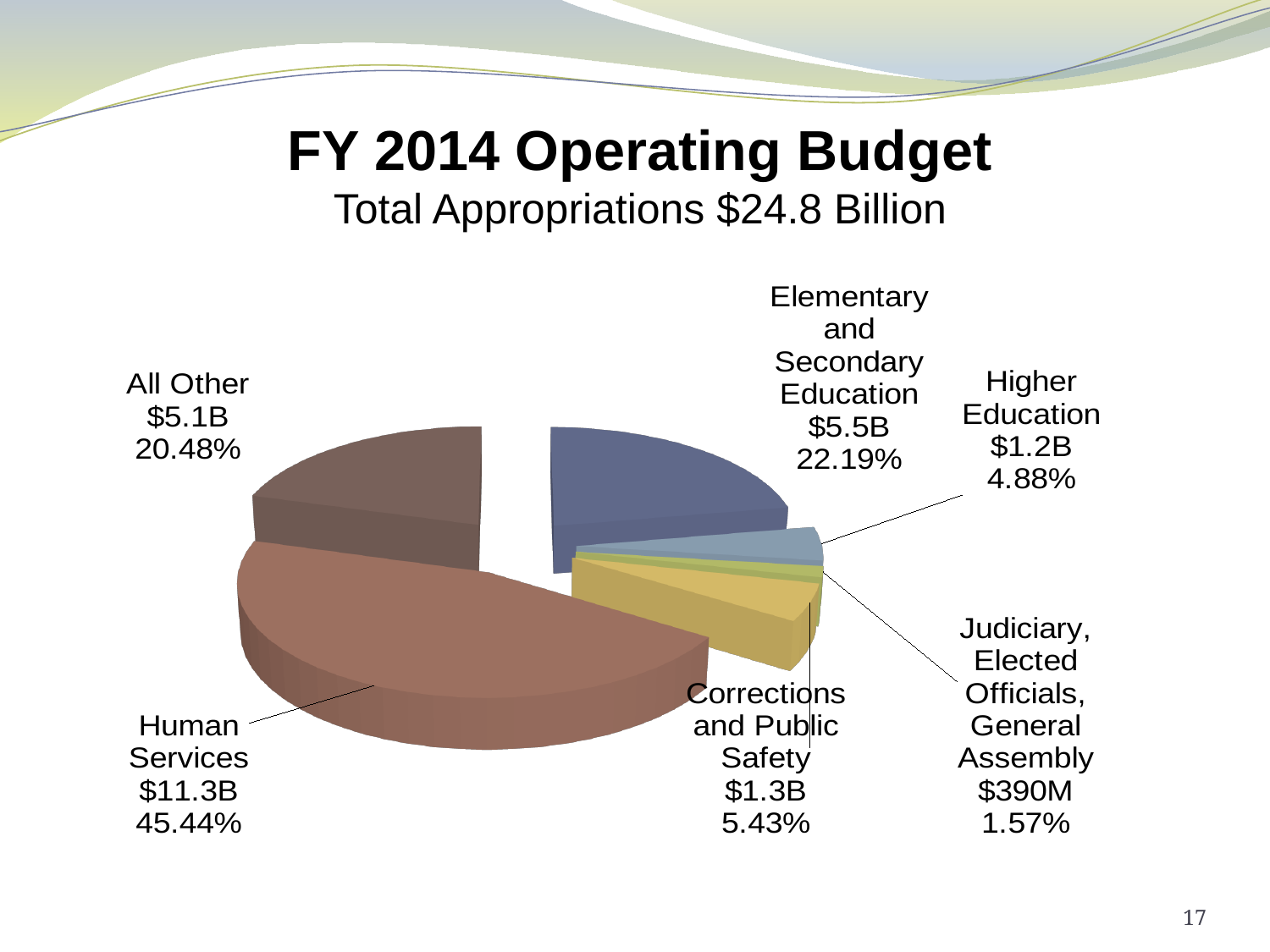
What total appropriations amount is stated in the chart's subtitle? $24.8 Billion What is the dollar amount for Human Services? $11.3B What kind of chart is shown on the slide? Pie chart What is the dollar amount for Judiciary, Elected Officials, General Assembly? $390M What percentage share does Elementary and Secondary Education have? 22.19% Which is larger, the share for Corrections and Public Safety or the share for Higher Education? Corrections and Public Safety How many slices does the pie chart have? 6 Which category has the smallest share of the pie? Judiciary, Elected Officials, General Assembly What percentage share does All Other have? 20.48% Which category has the largest share of the pie? Human Services What is the dollar amount for Higher Education? $1.2B What is the difference in percentage share between Elementary and Secondary Education and All Other? 1.71%